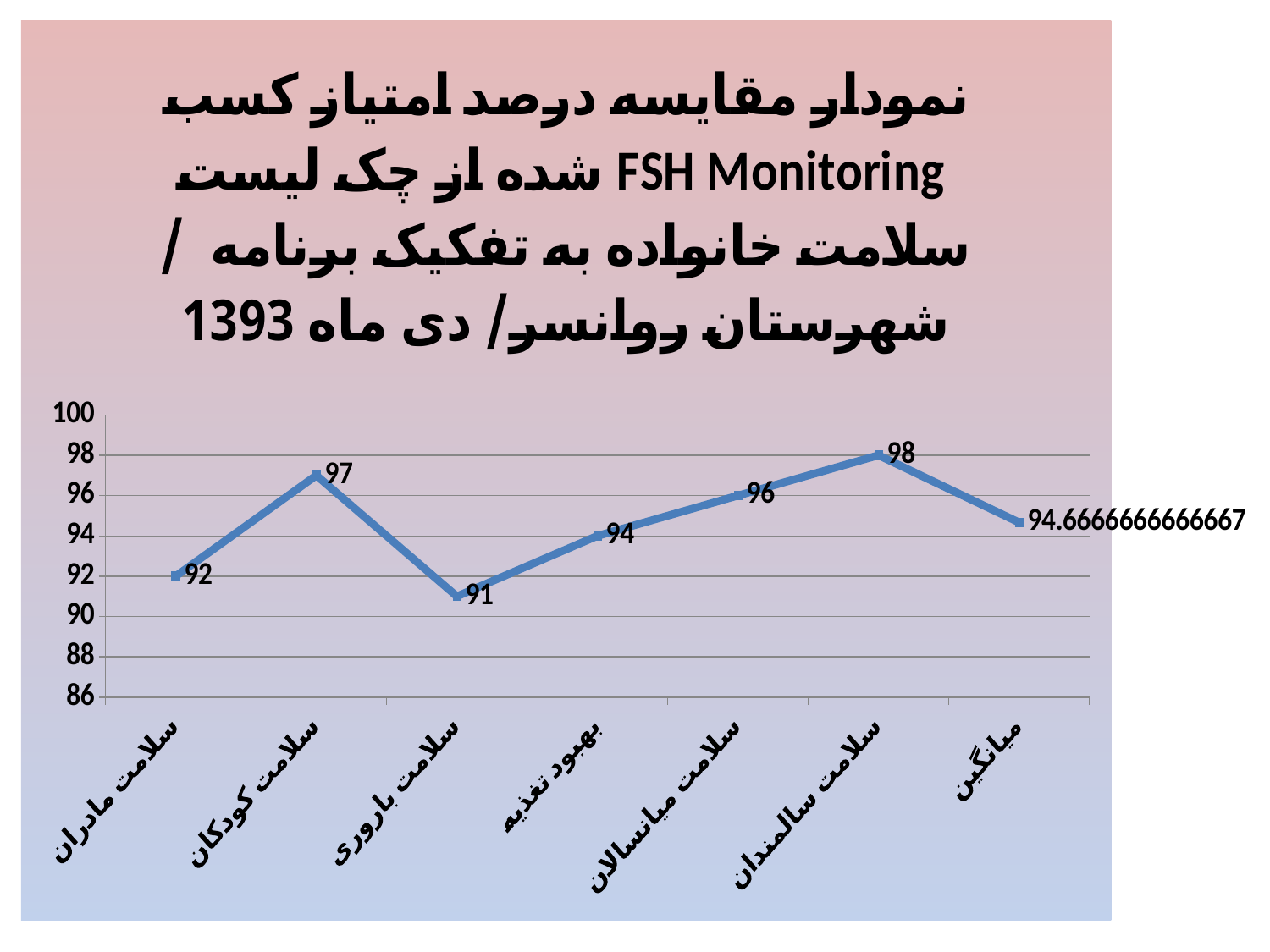
Do the values rise or fall from بهبود تغذیه to سلامت سالمندان? rise Which is larger, the value for بهبود تغذیه or the value for سلامت میانسالان? سلامت میانسالان What is the value for میانگین? 94.6666666666667 How many categories are plotted on the x axis? 7 What is the value for سلامت مادران? 92 Which category has the lowest value? سلامت باروری What is the value for سلامت کودکان? 97 What is the lowest value shown on the vertical axis? 86 Which category has the highest value? سلامت سالمندان What is the difference between the values for سلامت سالمندان and سلامت باروری? 7 What is the value for سلامت باروری? 91 What type of chart is shown on the slide? line chart